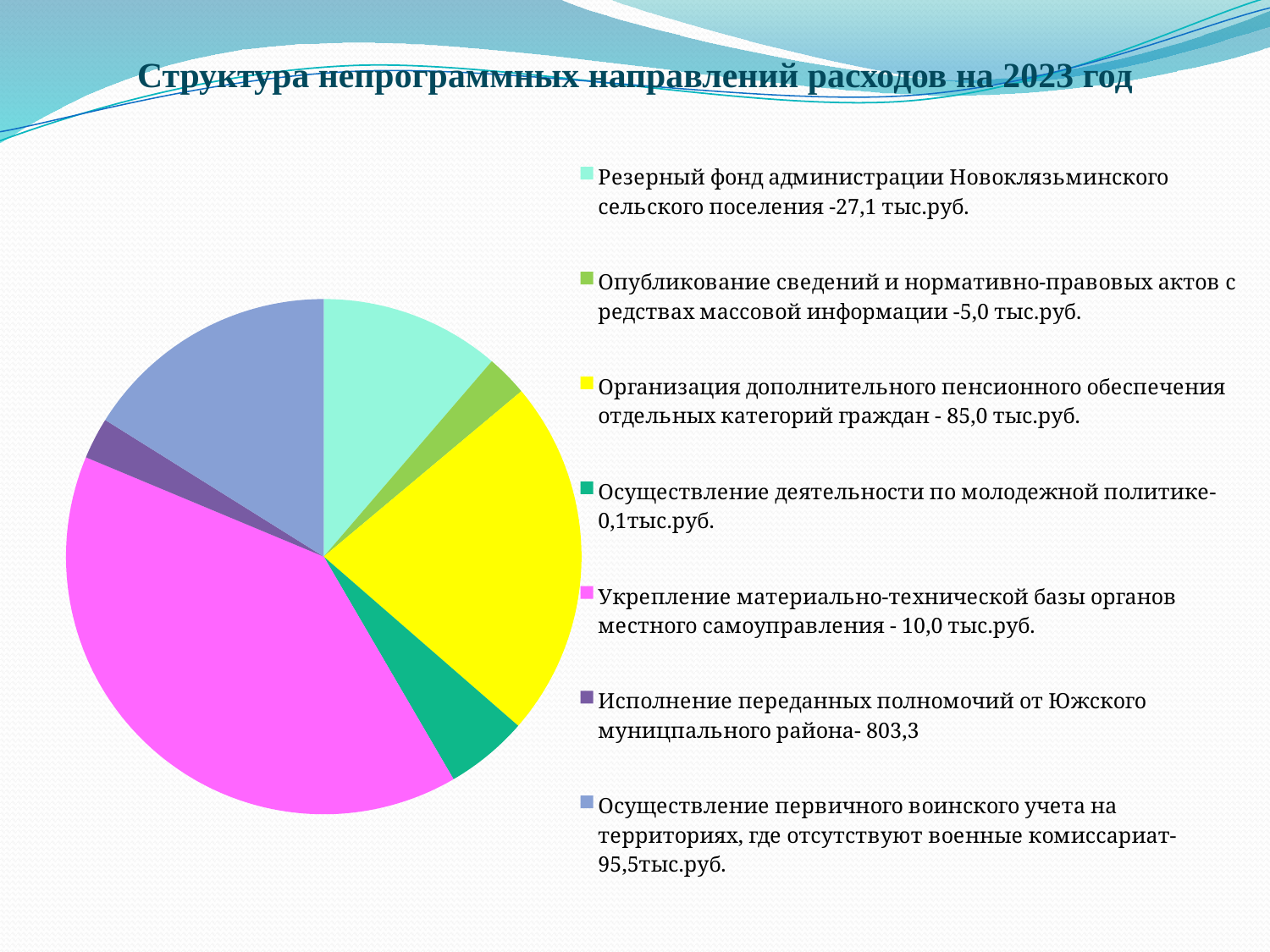
According to the legend, what is the value for Резерный фонд администрации Новоклязьминского сельского поселения? 27,1 тыс.руб. According to the legend, what is the value for Организация дополнительного пенсионного обеспечения отдельных категорий граждан? 85,0 тыс.руб. What kind of chart is shown on the slide? pie chart According to the legend, what is the value for Осуществление деятельности по молодежной политике? 0,1тыс.руб. According to the legend, what is the value for Исполнение переданных полномочий от Южского муницпального района? 803,3 According to the legend, what is the value for Осуществление первичного воинского учета на территориях, где отсутствуют военные комиссариат? 95,5тыс.руб. What is the title of the chart on the slide? Структура непрограммных направлений расходов на 2023 год What is the difference between the legend values for Осуществление первичного воинского учета (95,5) and Организация дополнительного пенсионного обеспечения (85,0)? 10,5 тыс.руб. How many categories does the pie chart's legend list? 7 According to the legend, what is the value for Укрепление материально-технической базы органов местного самоуправления? 10,0 тыс.руб. Which has the larger value in the legend: Организация дополнительного пенсионного обеспечения отдельных категорий граждан or Осуществление первичного воинского учета? Осуществление первичного воинского учета According to the legend, what is the value for Опубликование сведений и нормативно-правовых актов с редствах массовой информации? 5,0 тыс.руб.